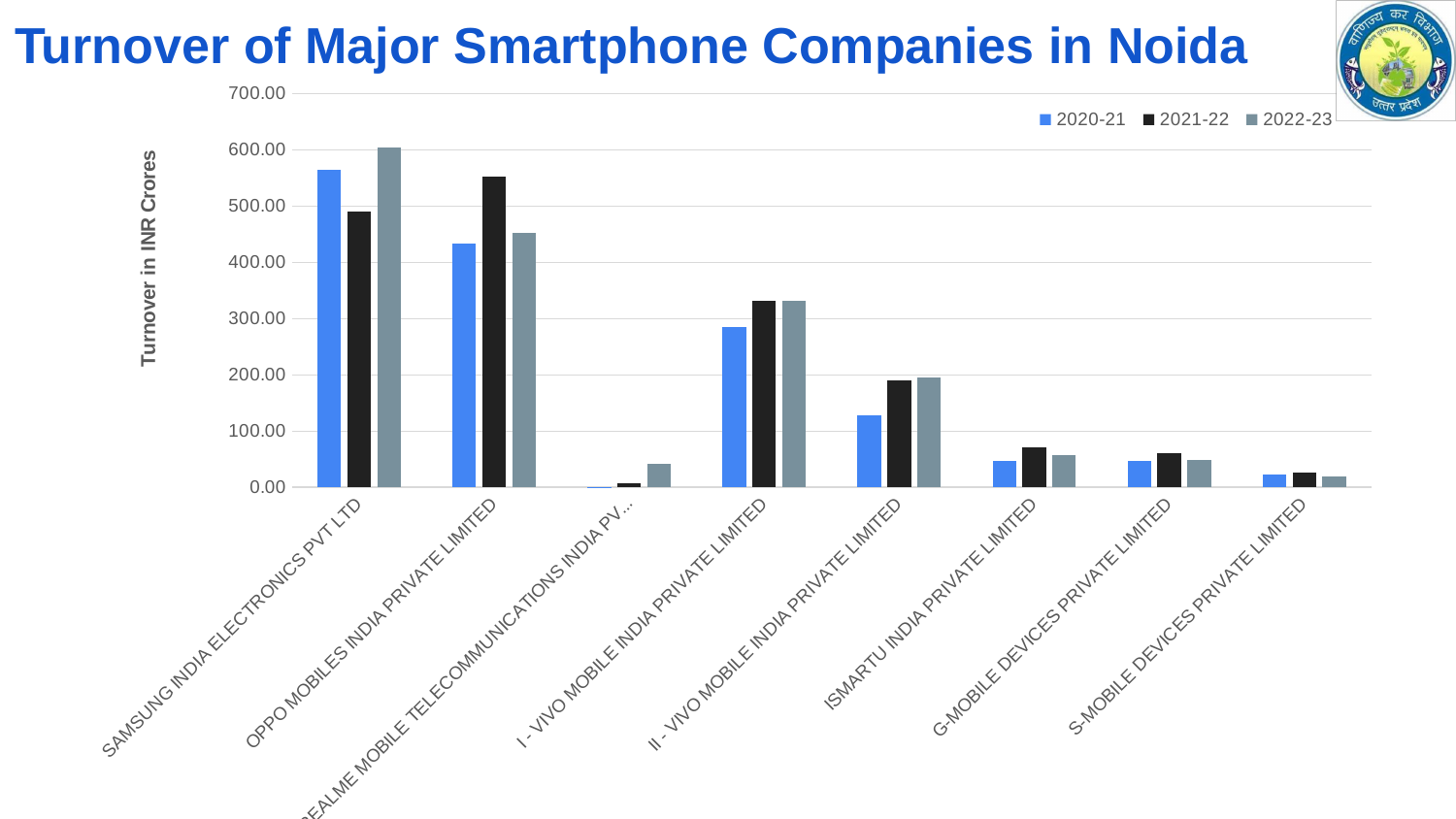
In 2020-21, which has the larger turnover: SAMSUNG INDIA ELECTRONICS PVT LTD or OPPO MOBILES INDIA PRIVATE LIMITED? SAMSUNG INDIA ELECTRONICS PVT LTD What kind of chart is shown on the slide? bar chart How many series does the legend list? 3 Is the 2021-22 turnover for OPPO MOBILES INDIA PRIVATE LIMITED greater or less than 500.00? greater Which company has the lowest turnover in 2020-21? REALME MOBILE TELECOMMUNICATIONS INDIA PVT LTD Is the 2020-21 turnover for II - VIVO MOBILE INDIA PRIVATE LIMITED greater or less than 200.00? less How many companies are shown on the x axis? 8 Which company has the highest turnover in 2022-23? SAMSUNG INDIA ELECTRONICS PVT LTD In 2021-22, which has the larger turnover: OPPO MOBILES INDIA PRIVATE LIMITED or SAMSUNG INDIA ELECTRONICS PVT LTD? OPPO MOBILES INDIA PRIVATE LIMITED What colour represents the 2021-22 series in the legend? black What is the title of the y axis? Turnover in INR Crores Is the 2020-21 turnover for SAMSUNG INDIA ELECTRONICS PVT LTD greater or less than 500.00? greater